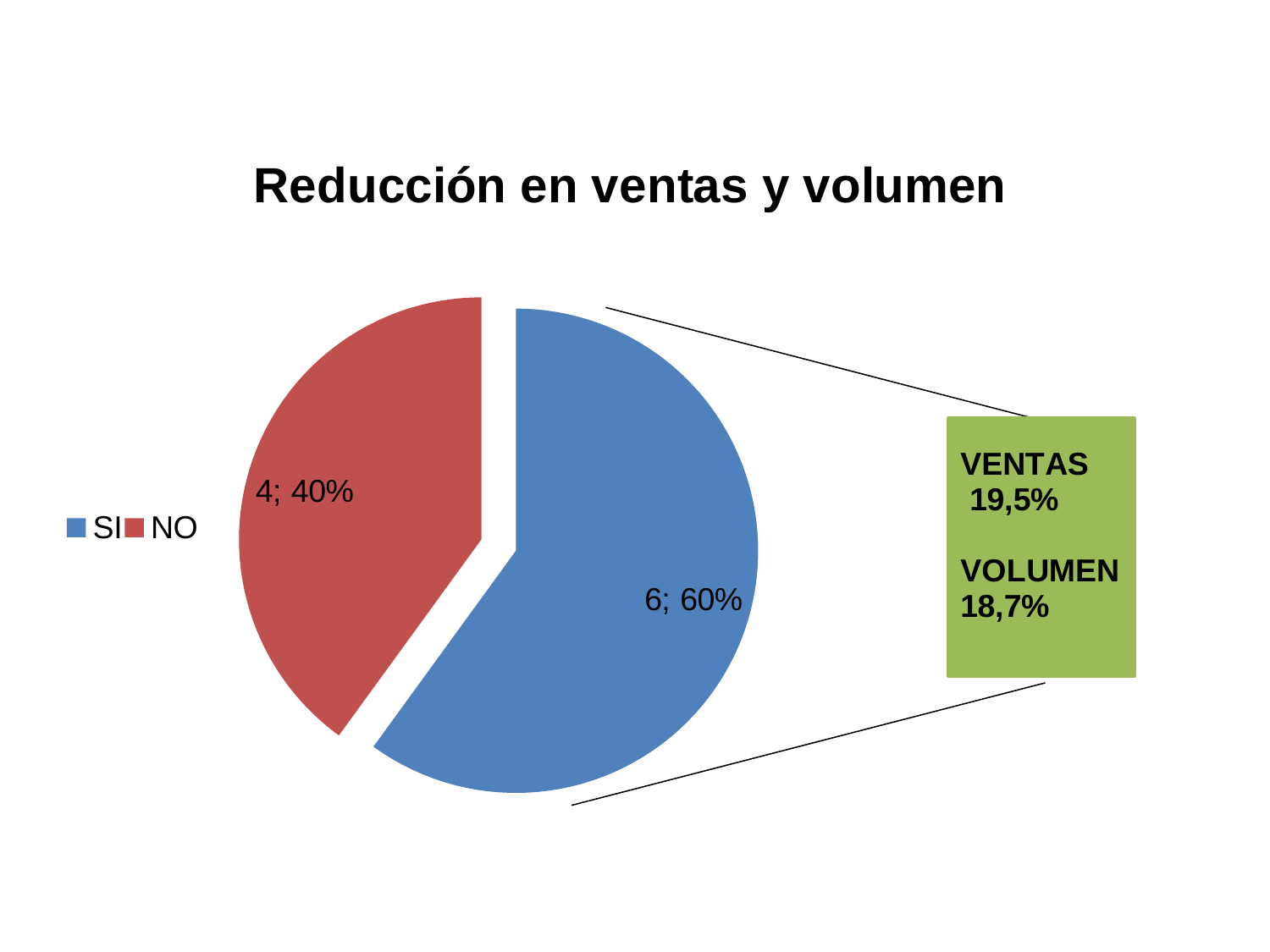
Which colour represents the NO slice? red What is the difference between the SI and NO counts? 2 What is the count value for the SI slice? 6 What kind of chart is shown on the slide? pie chart What is the title of the chart? Reducción en ventas y volumen How many entries does the legend list? 2 Which slice is the largest? SI What share of the pie does the SI slice represent? 60% Which slice is the smallest? NO What share of the pie does the NO slice represent? 40% How many slices does the pie chart have? 2 What is the count value for the NO slice? 4